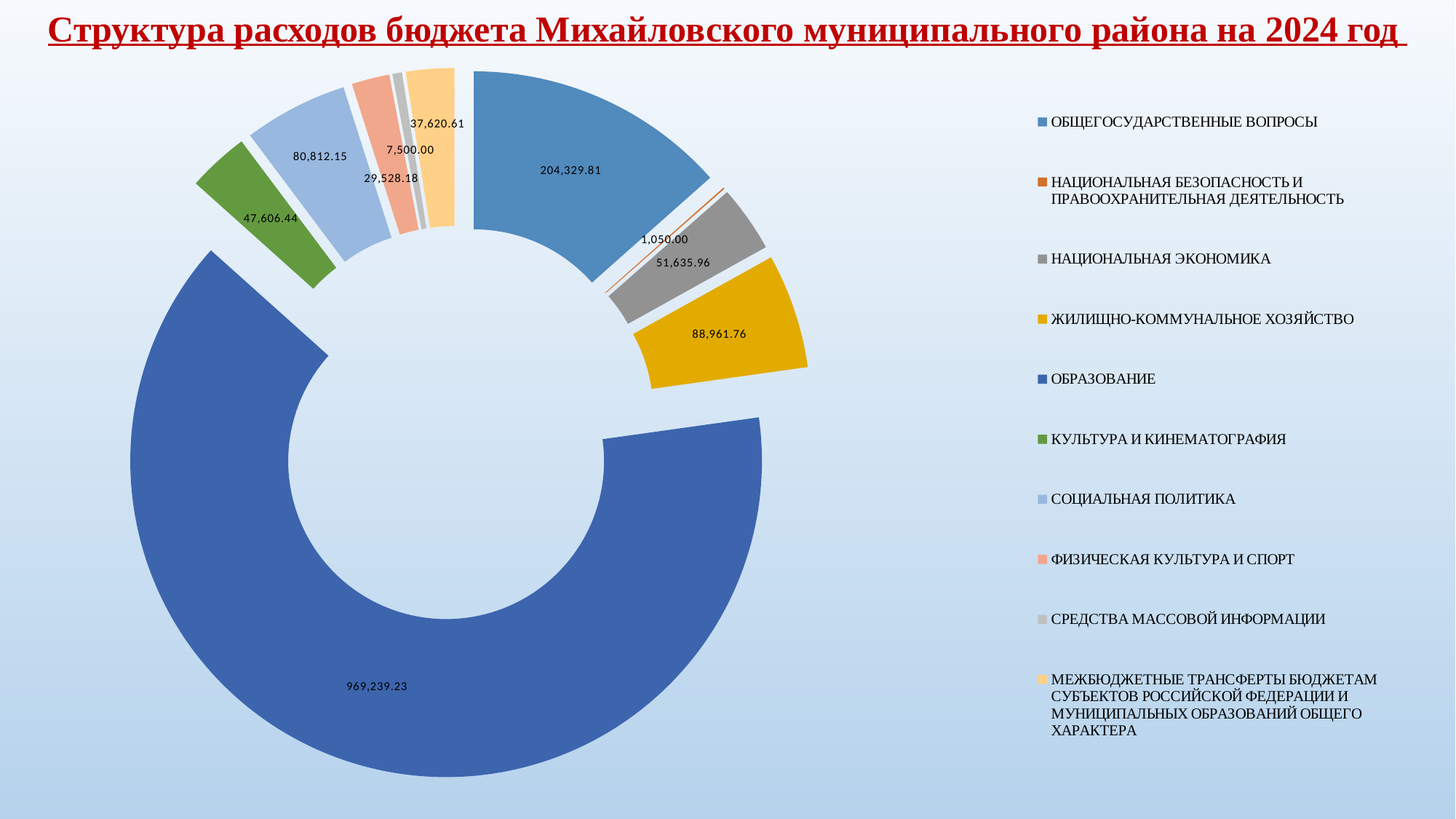
What kind of chart is shown on the slide? Doughnut chart Which is larger, СОЦИАЛЬНАЯ ПОЛИТИКА or ФИЗИЧЕСКАЯ КУЛЬТУРА И СПОРТ? СОЦИАЛЬНАЯ ПОЛИТИКА Which category has the largest value? ОБРАЗОВАНИЕ What value is shown for ОБЩЕГОСУДАРСТВЕННЫЕ ВОПРОСЫ? 204,329.81 What value is shown for ОБРАЗОВАНИЕ? 969,239.23 What value is shown for СРЕДСТВА МАССОВОЙ ИНФОРМАЦИИ? 7,500.00 What is the difference between the values for НАЦИОНАЛЬНАЯ ЭКОНОМИКА and КУЛЬТУРА И КИНЕМАТОГРАФИЯ? 4,029.52 What colour is the segment for ОБРАЗОВАНИЕ? Dark blue What is the difference between the values for ОБЩЕГОСУДАРСТВЕННЫЕ ВОПРОСЫ and ЖИЛИЩНО-КОММУНАЛЬНОЕ ХОЗЯЙСТВО? 115,368.05 What value is shown for ЖИЛИЩНО-КОММУНАЛЬНОЕ ХОЗЯЙСТВО? 88,961.76 How many categories does the chart show? 10 Which category has the smallest value? НАЦИОНАЛЬНАЯ БЕЗОПАСНОСТЬ И ПРАВООХРАНИТЕЛЬНАЯ ДЕЯТЕЛЬНОСТЬ